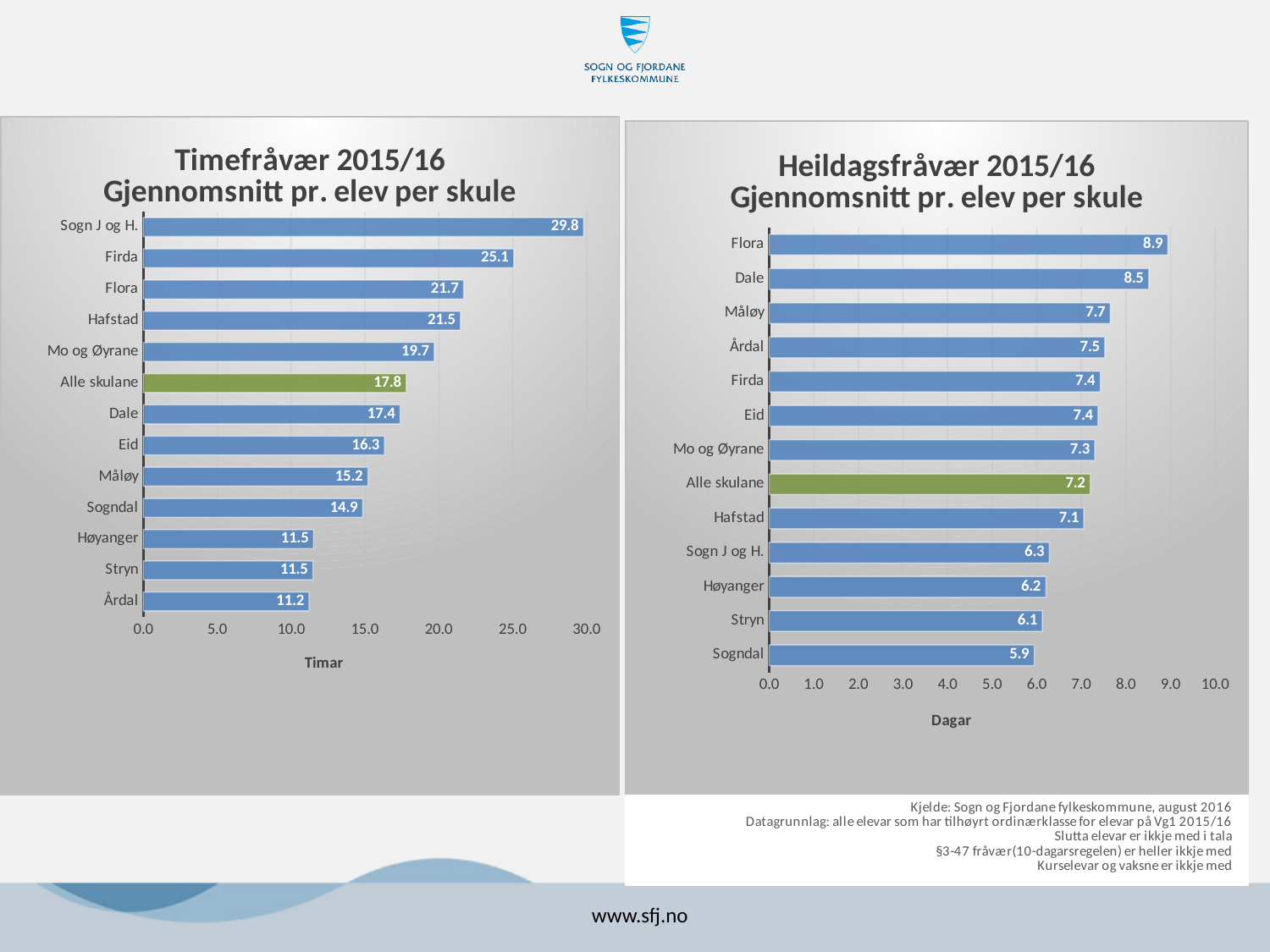
In the Heildagsfråvær 2015/16 chart, which category has the lowest value? Sogndal In the Timefråvær 2015/16 chart, what is the value for Firda? 25.1 What type of chart is the Heildagsfråvær 2015/16 chart? Bar chart In the Timefråvær 2015/16 chart, what is the x-axis title? Timar In the Timefråvær 2015/16 chart, which school has the highest value? Sogn J og H. In the Timefråvær 2015/16 chart, what is the difference between Sogn J og H. and Alle skulane? 12.0 In the Heildagsfråvær 2015/16 chart, what is the difference between Flora and Sogndal? 3.0 In the Heildagsfråvær 2015/16 chart, what is the value for Måløy? 7.7 In the Heildagsfråvær 2015/16 chart, which school has the highest value? Flora In the Timefråvær 2015/16 chart, which category has the lowest value? Årdal In the Heildagsfråvær 2015/16 chart, which is larger, the value for Dale or the value for Hafstad? Dale In the Timefråvær 2015/16 chart, how many bars are plotted? 13